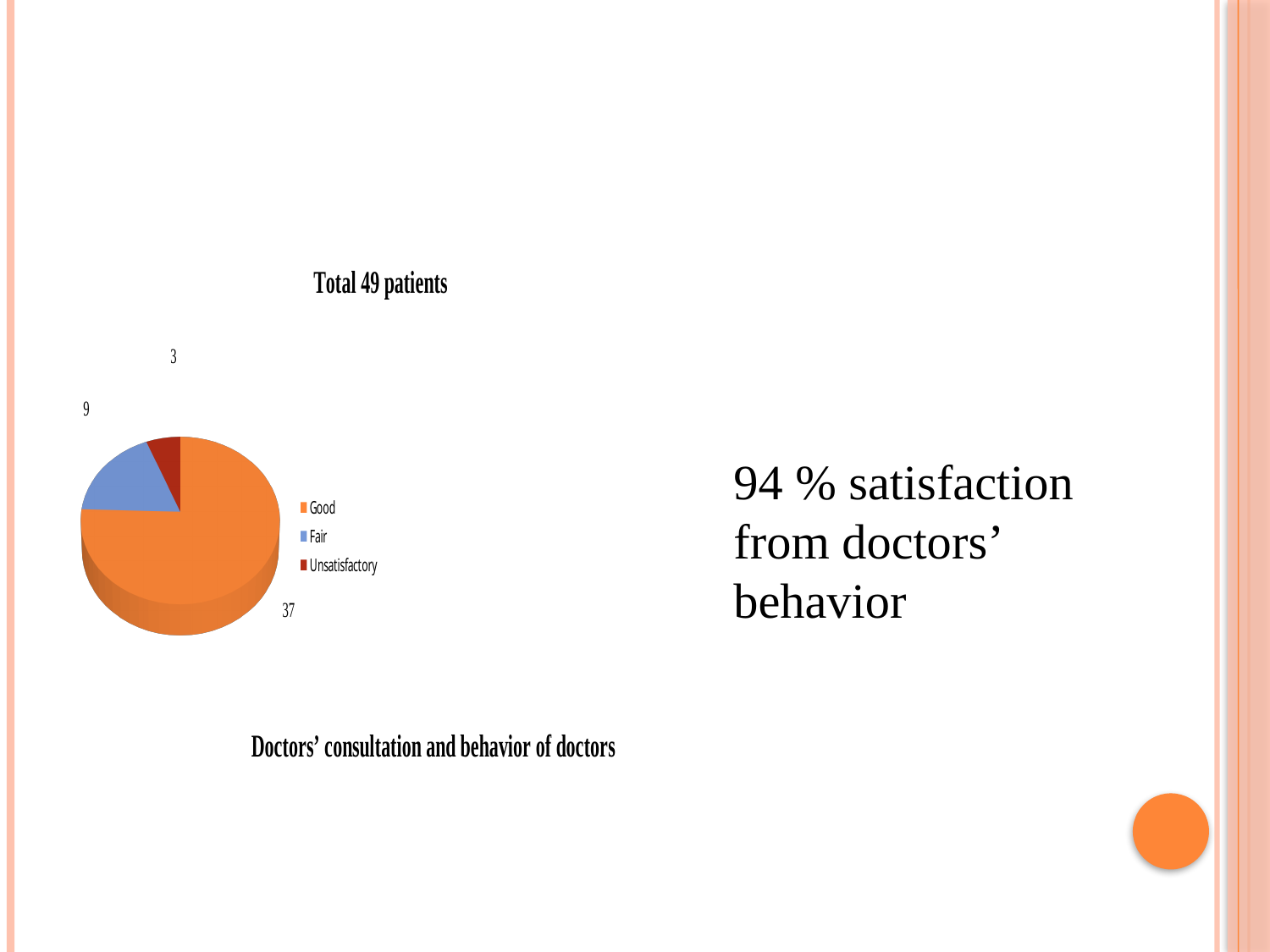
What is the difference between the values for Good and Fair? 28 What is the value for Unsatisfactory? 3 What is the value for Fair? 9 What kind of chart is shown on the slide? pie chart What is the value for Good? 37 Which is larger, the value for Fair or the value for Unsatisfactory? Fair What is the difference between the values for Fair and Unsatisfactory? 6 What colour is the Fair slice? blue Which category has the smallest slice? Unsatisfactory Which category has the largest slice? Good How many categories does the pie chart have? 3